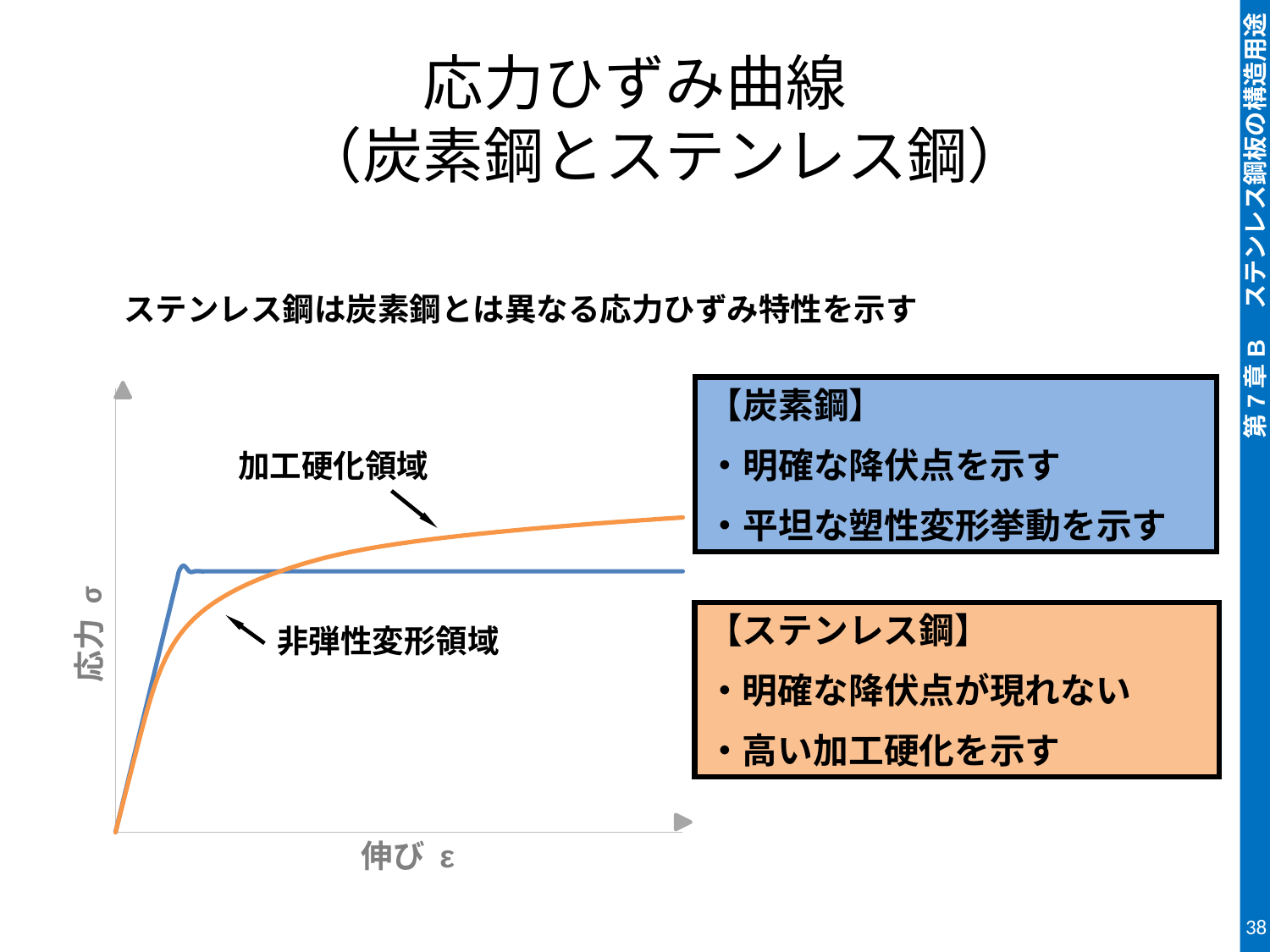
Which region label on the chart points to the upper part of the orange curve? 加工硬化領域 Which material does the orange curve represent according to the colour-matched box on the slide? ステンレス鋼 How many curves are plotted on the chart? 2 At the right end of the chart, which curve is higher, the orange curve or the blue curve? The orange curve What is the label of the horizontal axis of the chart? 伸び ε Which curve shows a clear yield point (a small peak followed by a flat plateau), the blue or the orange? The blue curve What kind of chart is shown on the slide? Line chart After its initial peak, does the blue curve rise, fall, or stay flat as 伸び ε increases? Stays flat Does the orange curve rise or fall as 伸び ε increases? Rises